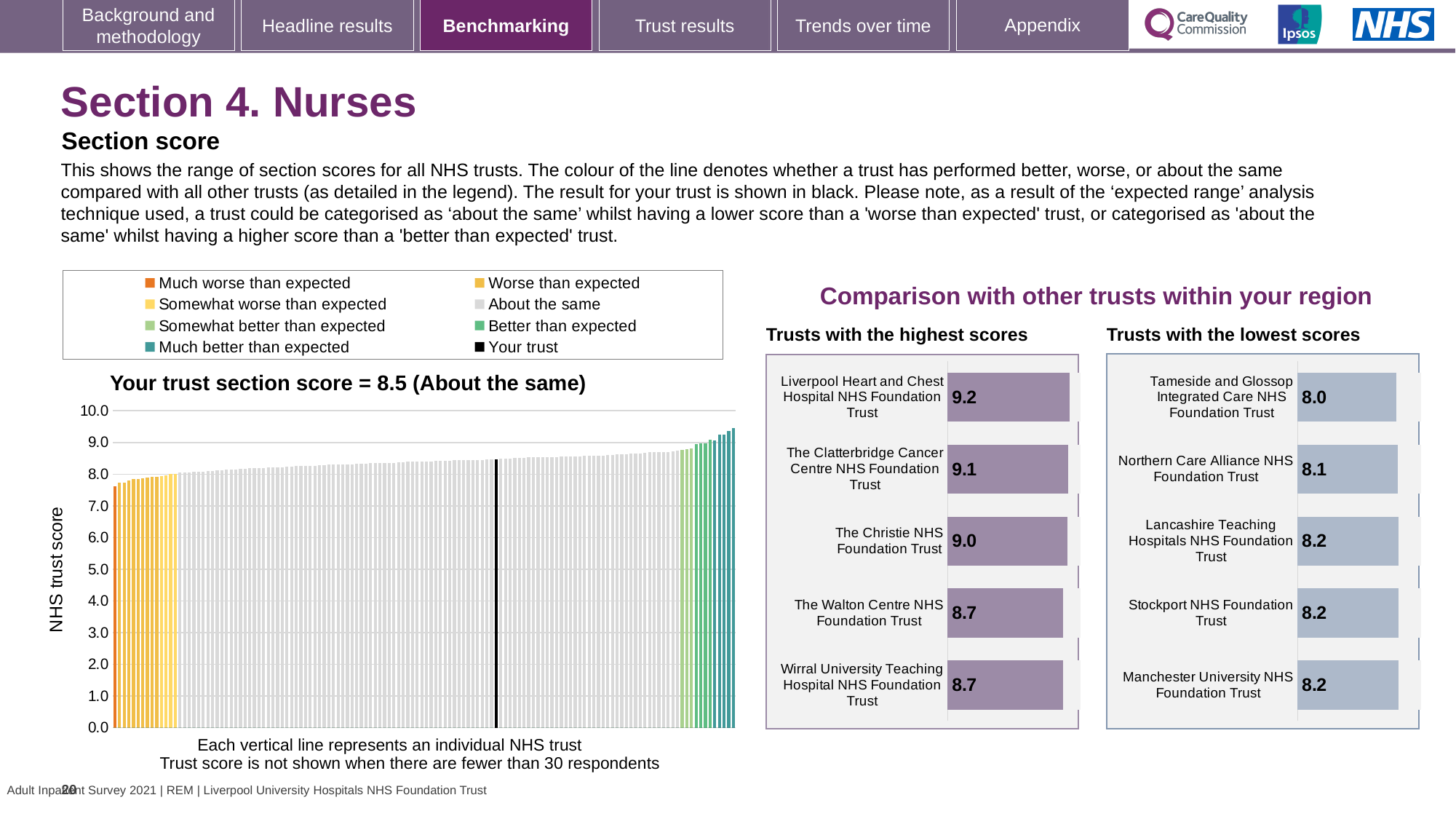
On the main chart of all NHS trusts, what is the section score for your trust? 8.5 How many entries does the legend above the main chart list? 8 On the main chart of all NHS trusts, what category is your trust placed in according to the chart title? About the same In the 'Trusts with the lowest scores' chart, what is the difference between the scores of Stockport NHS Foundation Trust and Tameside and Glossop Integrated Care NHS Foundation Trust? 0.2 In the 'Trusts with the highest scores' chart, what is the difference between the scores of Liverpool Heart and Chest Hospital NHS Foundation Trust and The Walton Centre NHS Foundation Trust? 0.5 In the 'Trusts with the highest scores' chart, which trust has the highest score? Liverpool Heart and Chest Hospital NHS Foundation Trust In the 'Trusts with the lowest scores' chart, which trust has the lowest score? Tameside and Glossop Integrated Care NHS Foundation Trust In the 'Trusts with the highest scores' chart, what is the score for The Christie NHS Foundation Trust? 9.0 In the 'Trusts with the lowest scores' chart, what is the score for Northern Care Alliance NHS Foundation Trust? 8.1 In the 'Trusts with the highest scores' chart, how many trusts are listed? 5 On the main chart of all NHS trusts, do the trust scores rise or fall from left to right? rise On the main chart of all NHS trusts, what kind of chart is shown? bar chart